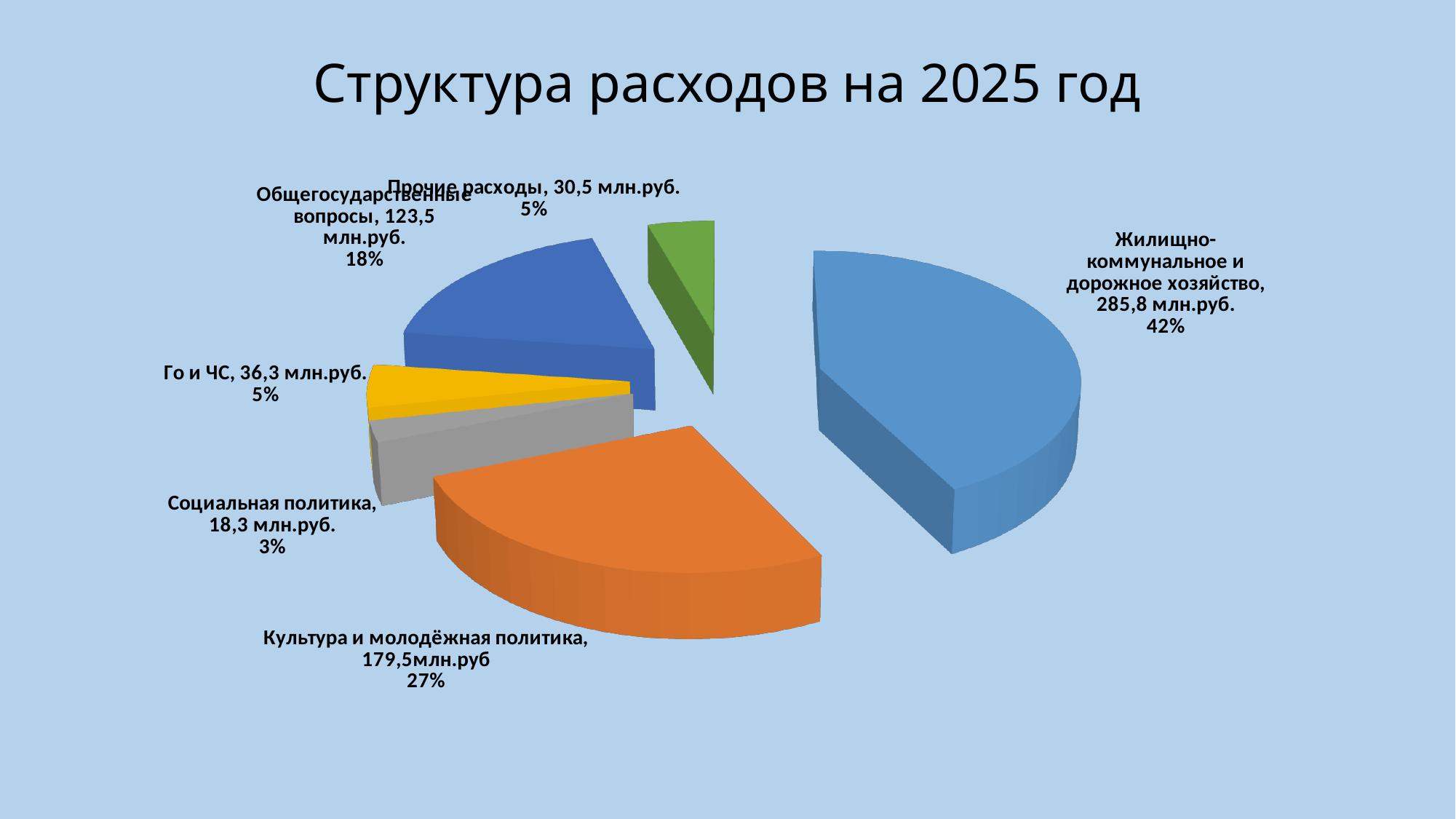
What is the value for Жилищно-коммунальное и дорожное хозяйство? 285,8 млн.руб. Which category has the smallest slice? Социальная политика What is the value for Культура и молодёжная политика? 179,5 млн.руб What share of the pie does Социальная политика take? 3% Which category has the largest slice? Жилищно-коммунальное и дорожное хозяйство What share of the pie does Общегосударственные вопросы take? 18% What is the difference between Жилищно-коммунальное и дорожное хозяйство and Культура и молодёжная политика? 106,3 млн.руб. What is the title of the chart? Структура расходов на 2025 год What is the value for Го и ЧС? 36,3 млн.руб. Which is larger: Го и ЧС or Прочие расходы? Го и ЧС How many slices does the pie chart have? 6 What kind of chart is shown on the slide? Pie chart